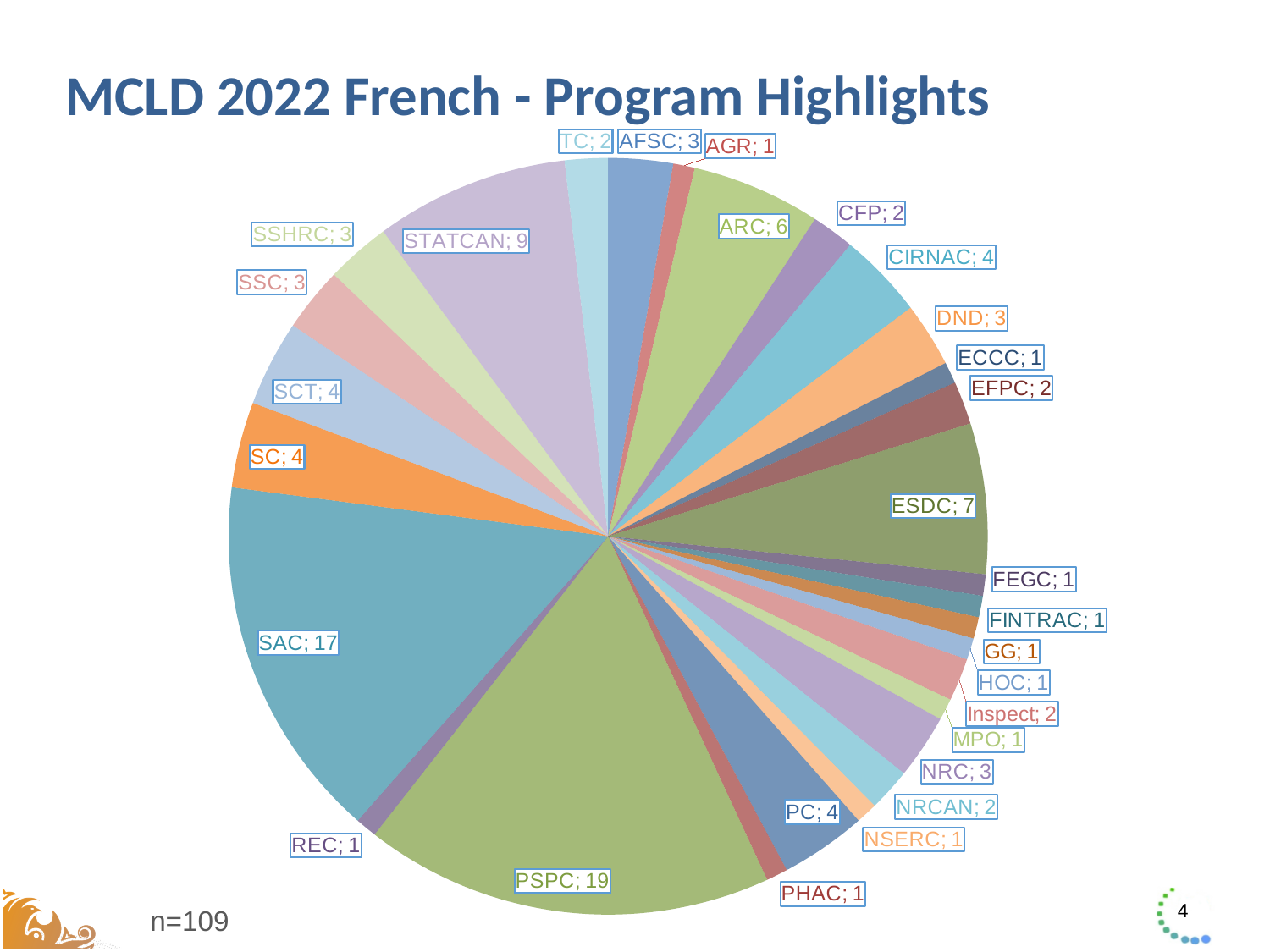
What is the title of the chart? MCLD 2022 French - Program Highlights What is the value for SAC? 17 What is the value for STATCAN? 9 What is the difference between the values for STATCAN and ESDC? 2 What type of chart is shown on the slide? Pie chart Which is larger, the value for ARC or the value for CIRNAC? ARC Which category has the largest slice of the pie? PSPC What is the value for PSPC? 19 What is the difference between the values for PSPC and SAC? 2 How many categories are shown in the pie chart? 29 What total sample size (n) is stated on the slide? n=109 What is the value for ESDC? 7